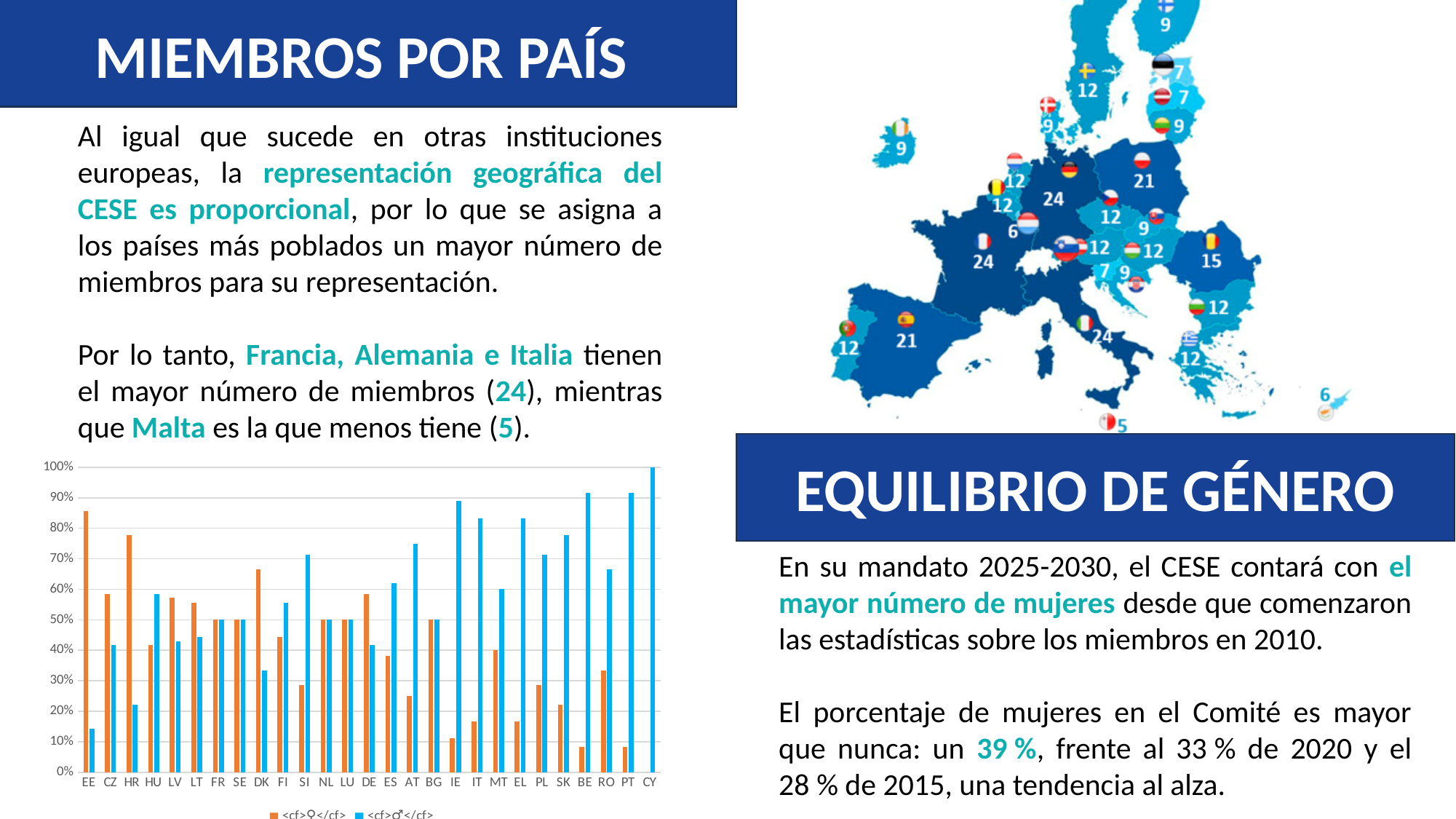
In the bar chart, what is the value of the orange bar for FR? 50% In the bar chart, what is the value of the blue bar for CY? 100% In the bar chart, which country has the highest orange bar? EE In the bar chart, which is larger for PT, the orange bar or the blue bar? the blue bar In the bar chart, which country has the highest blue bar? CY In the bar chart, which country has the lowest blue bar? EE In the bar chart, is the orange value for EE greater or less than 80%? greater How many series does the legend of the bar chart list? 2 In the bar chart, which is larger for HR, the orange bar or the blue bar? the orange bar What kind of chart is shown at the bottom left of the slide? bar chart In the bar chart, is the blue value for IE greater or less than 80%? greater How many countries are shown on the x axis of the bar chart? 27